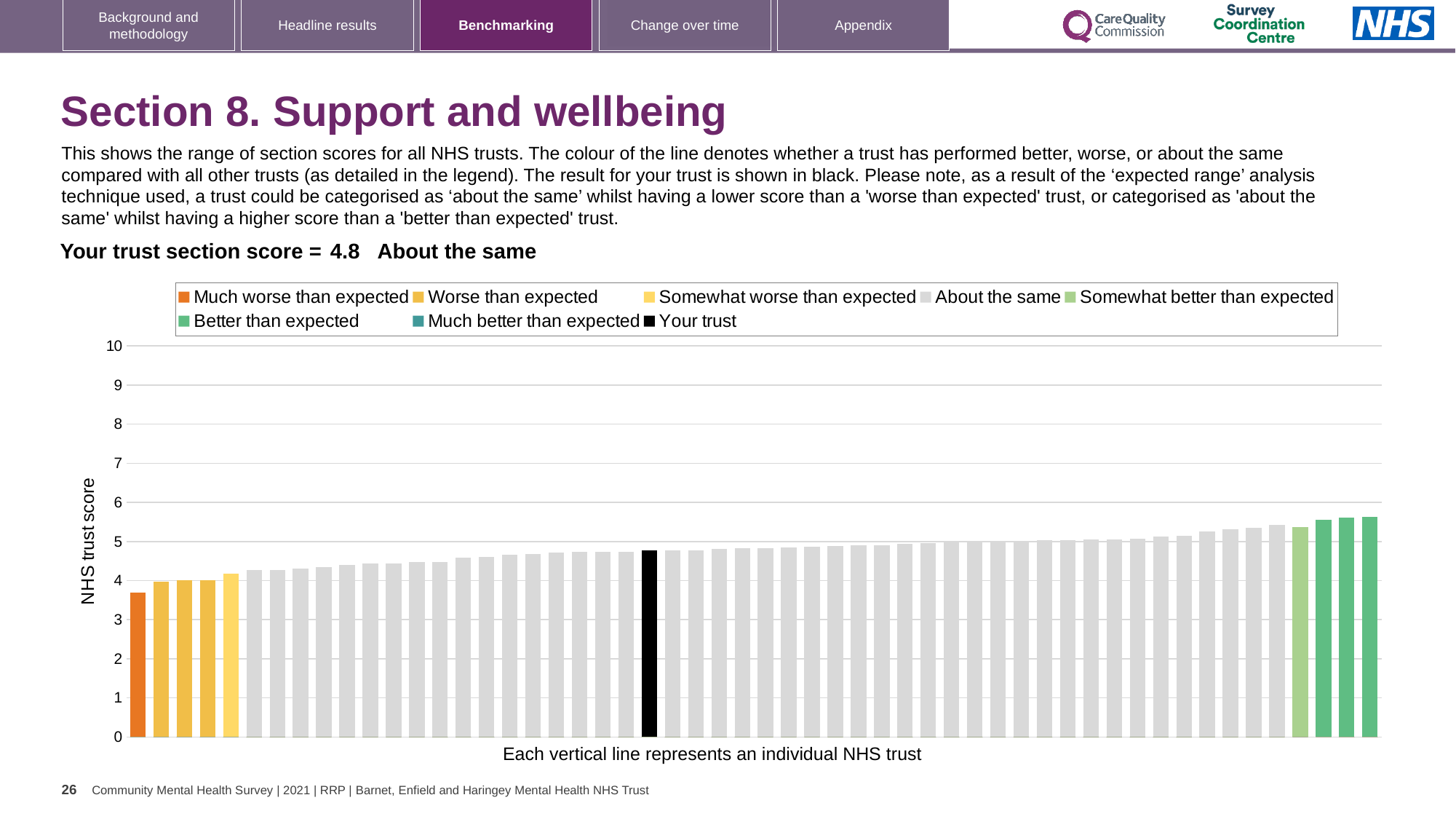
What is the section score for your trust shown on the slide? 4.8 How many entries does the chart legend list? 8 Do the bar values rise or fall moving from left to right along the x axis? rise What kind of chart is shown on the slide? bar chart Which benchmarking category is your trust placed in for Section 8? About the same How many bars are coloured as 'Worse than expected' (the darker yellow bars)? 3 Is the value of the tallest bar greater or less than 6? less What is the label on the y axis of the chart? NHS trust score Is the value of the lowest bar (the orange one) greater or less than 4? less How many bars are coloured as 'Better than expected' (the darker green bars)? 3 Which legend category does the lowest bar belong to? Much worse than expected Is the value of the black 'Your trust' bar greater or less than 4? greater